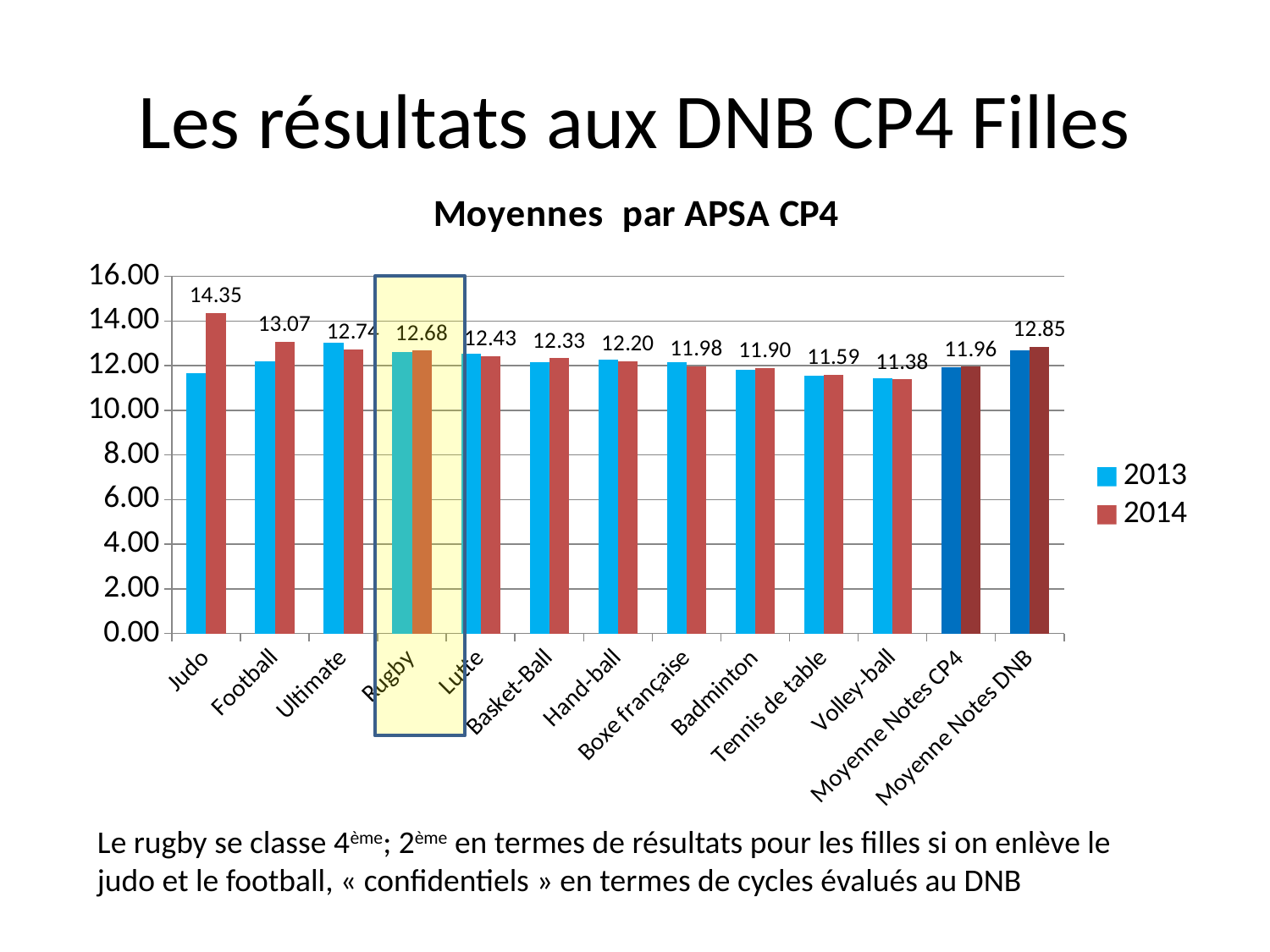
What is the 2014 value for Moyenne Notes DNB? 12.85 How many series does the legend list? 2 Which category has the lowest 2014 value? Volley-ball How many categories are shown on the x axis? 13 What is the 2014 value for Tennis de table? 11.59 What is the 2014 value for Judo? 14.35 What kind of chart is shown? bar chart What is the 2014 value for Rugby? 12.68 Which category has the highest 2014 value? Judo Is the 2013 value for Judo greater or less than 12.00? less Which has the larger 2014 value, Lutte or Basket-Ball? Lutte What is the difference between the 2014 values for Judo and Football? 1.28